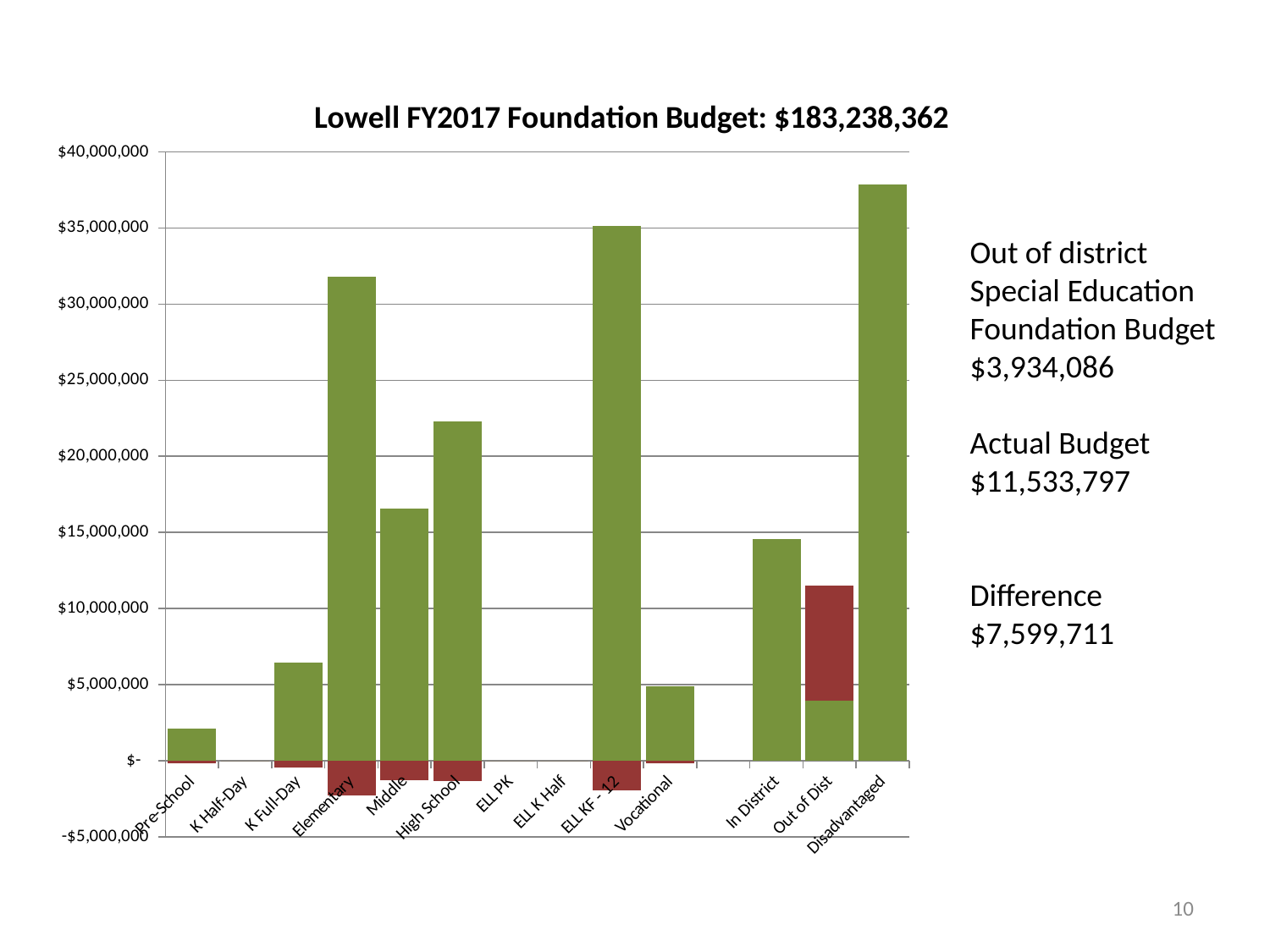
Is the green bar for K Full-Day greater or less than $5,000,000? greater According to the text on the slide, what is the Difference between the Out of district actual budget and the foundation budget? $7,599,711 Which has the taller green bar, Middle or In District? Middle Is the green bar for High School greater or less than $20,000,000? greater According to the text on the slide, what is the Out of district Special Education Foundation Budget? $3,934,086 Is the green bar for Elementary greater or less than $30,000,000? greater Which category has the tallest green bar? Disadvantaged Which has the taller green bar, Elementary or High School? Elementary What is the title of the chart? Lowell FY2017 Foundation Budget: $183,238,362 What kind of chart is shown on the slide? bar chart